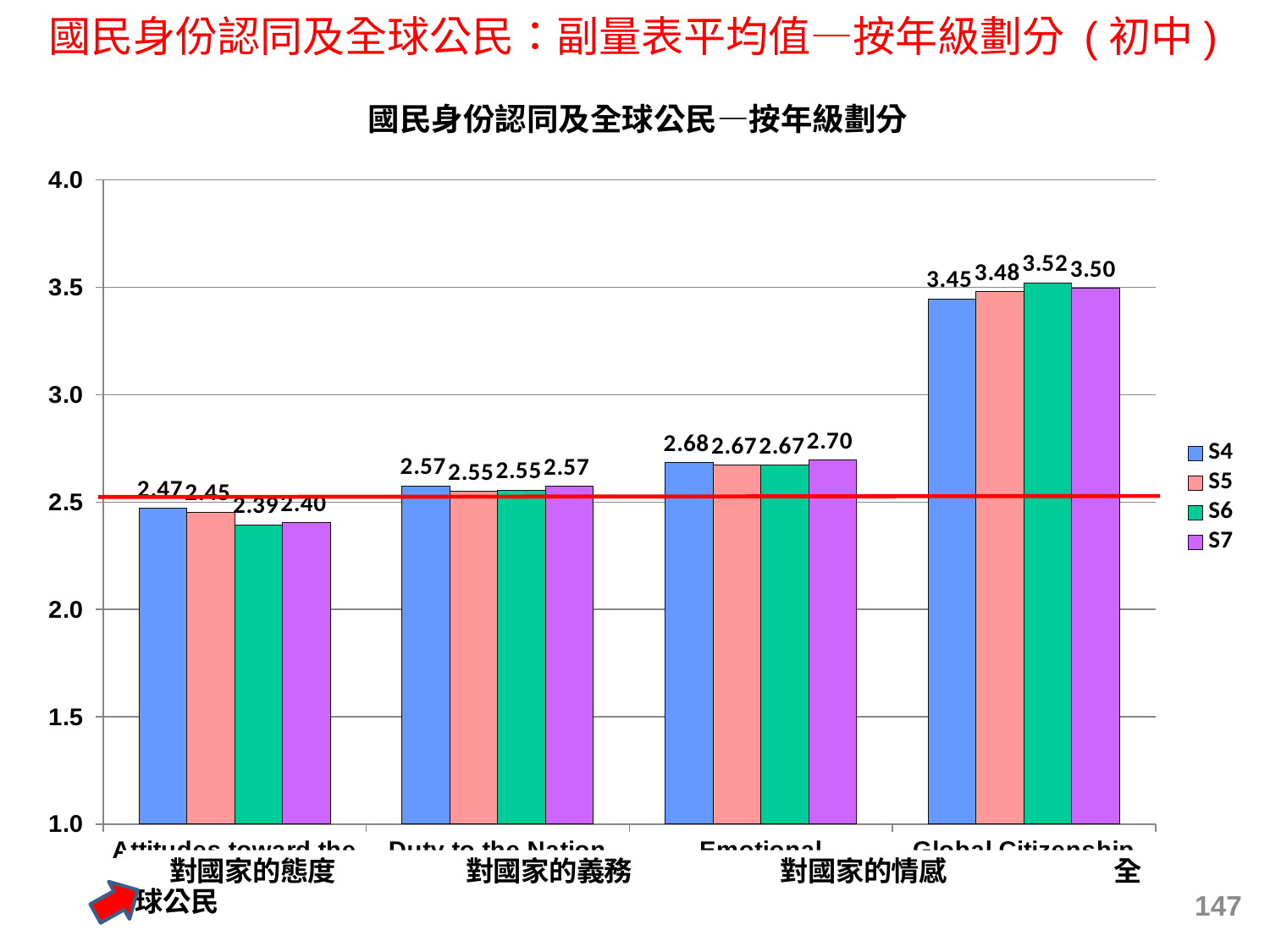
Which is larger: the S4 value for 對國家的態度 or the S4 value for 對國家的義務? 對國家的義務 What is the value for S7 in the 對國家的情感 category? 2.70 What is the value for S6 in the 全球公民 category? 3.52 How many categories are shown on the x axis? 4 What kind of chart is shown on the slide? bar chart What is the difference between the S6 and S4 values in the 全球公民 category? 0.07 What is the value for S5 in the 對國家的義務 category? 2.55 Which series has the highest value in the 全球公民 category? S6 How many series does the legend list? 4 Which series has the lowest value in the 對國家的態度 category? S6 What is the value for S4 in the 對國家的態度 category? 2.47 Is the S5 value for 全球公民 greater or less than 3.0? greater